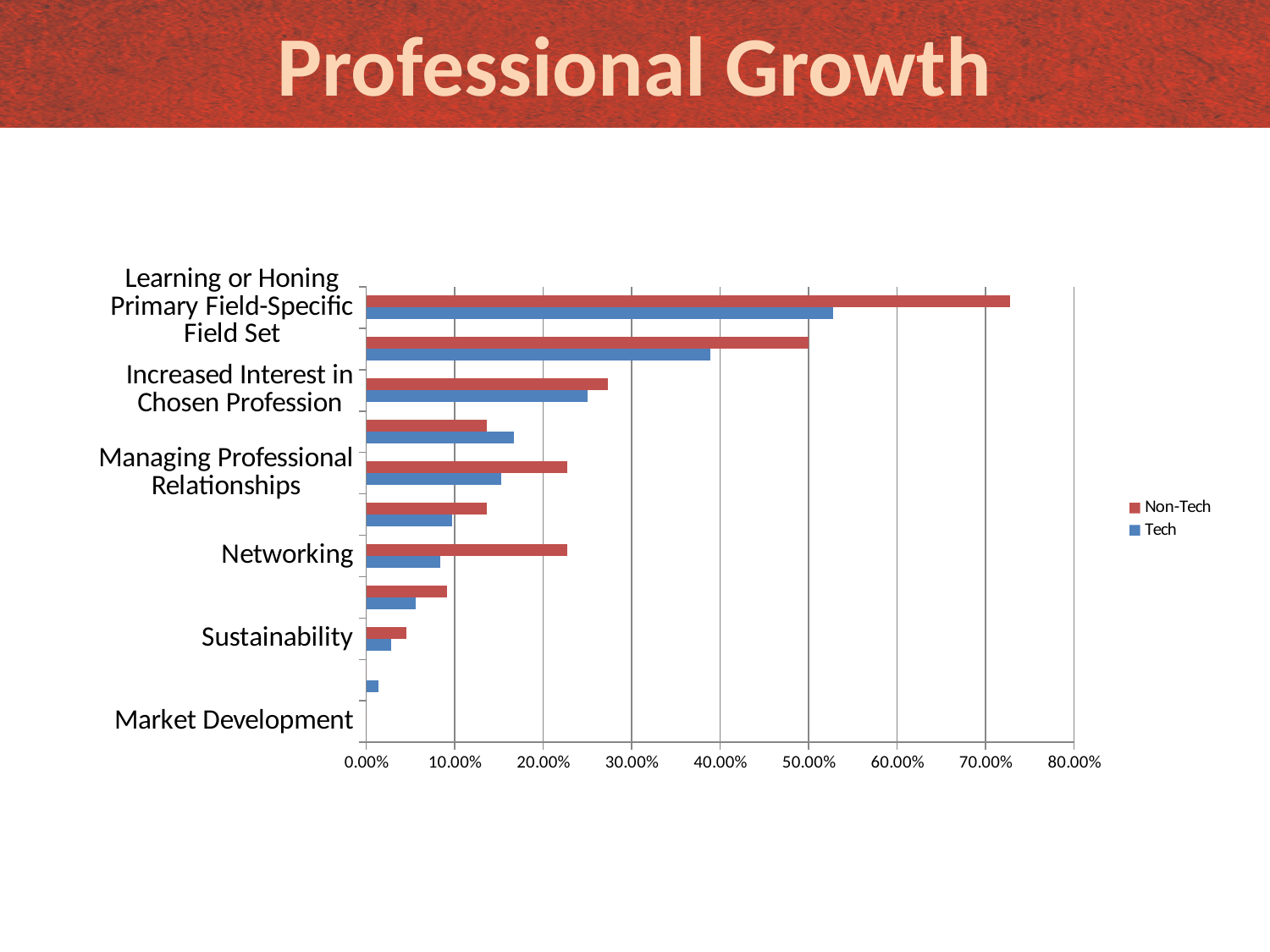
For Networking, which series has the larger value, Non-Tech or Tech? Non-Tech Which category has the highest Tech value? Learning or Honing Primary Field-Specific Field Set Is the Non-Tech value for Managing Professional Relationships greater or less than 30.00%? less How many series does the legend list? 2 What are the two series named in the legend? Non-Tech and Tech What is the title of the slide containing the chart? Professional Growth Which category has the highest Non-Tech value? Learning or Honing Primary Field-Specific Field Set What kind of chart is shown on the slide? bar chart Is the Tech value for Networking greater or less than 10.00%? less Is the Tech value for Learning or Honing Primary Field-Specific Field Set greater or less than 40.00%? greater